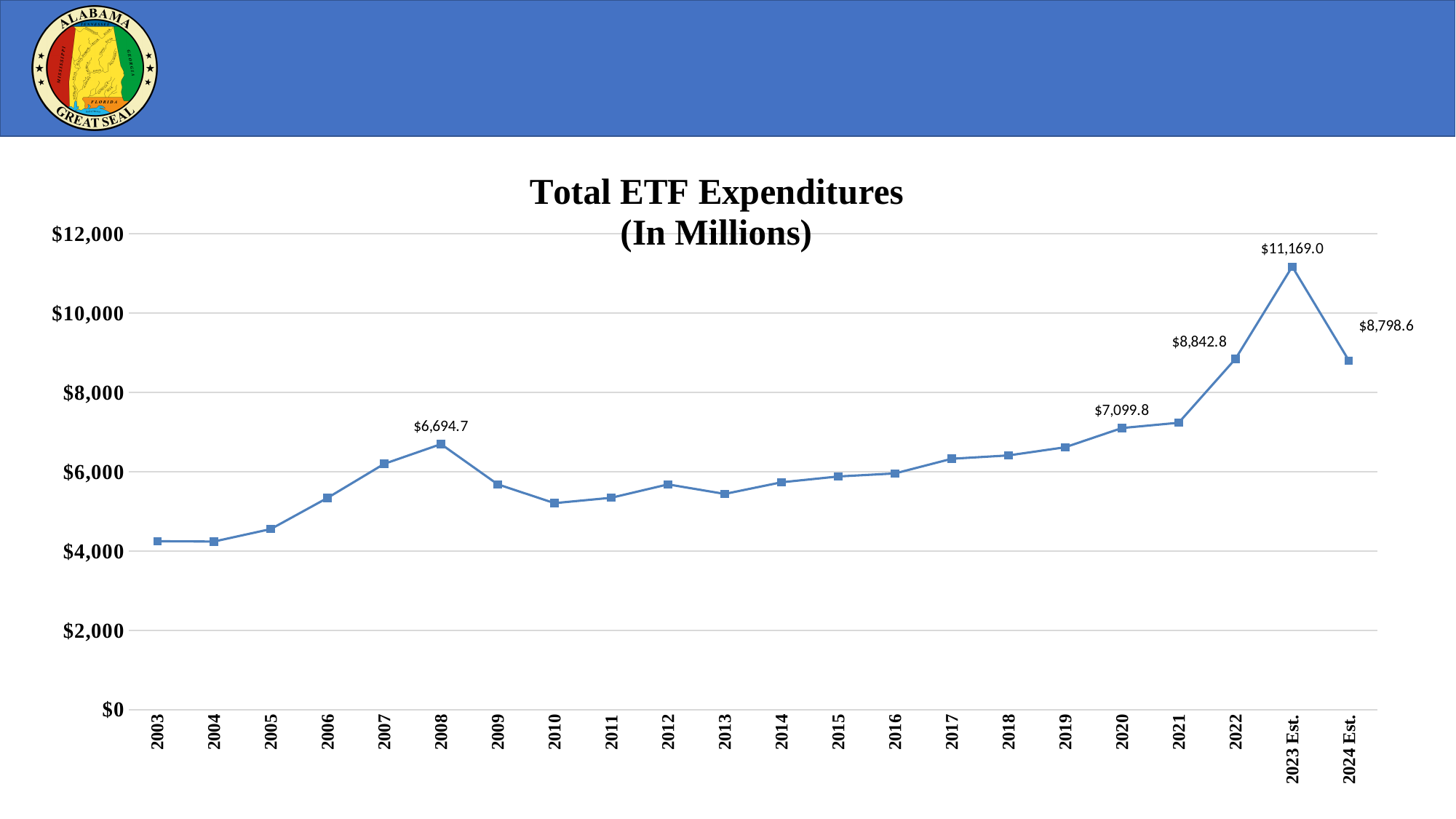
Is the value for 2010 greater or less than $6,000? less What is the difference between the 2020 value and the 2008 value? $405.1 Which is larger, the value for 2022 or the value for 2024 Est.? 2022 What is the value for 2023 Est. in the Total ETF Expenditures chart? $11,169.0 What is the value for 2008 in the Total ETF Expenditures chart? $6,694.7 What is the value for 2022 in the Total ETF Expenditures chart? $8,842.8 Which year has the highest Total ETF Expenditures? 2023 Est. What kind of chart is shown on the slide? Line chart How many years are plotted on the x axis of the chart? 22 What is the value for 2024 Est. in the Total ETF Expenditures chart? $8,798.6 Is the value for 2021 greater or less than $6,000? greater What is the difference between the 2023 Est. value and the 2022 value? $2,326.2